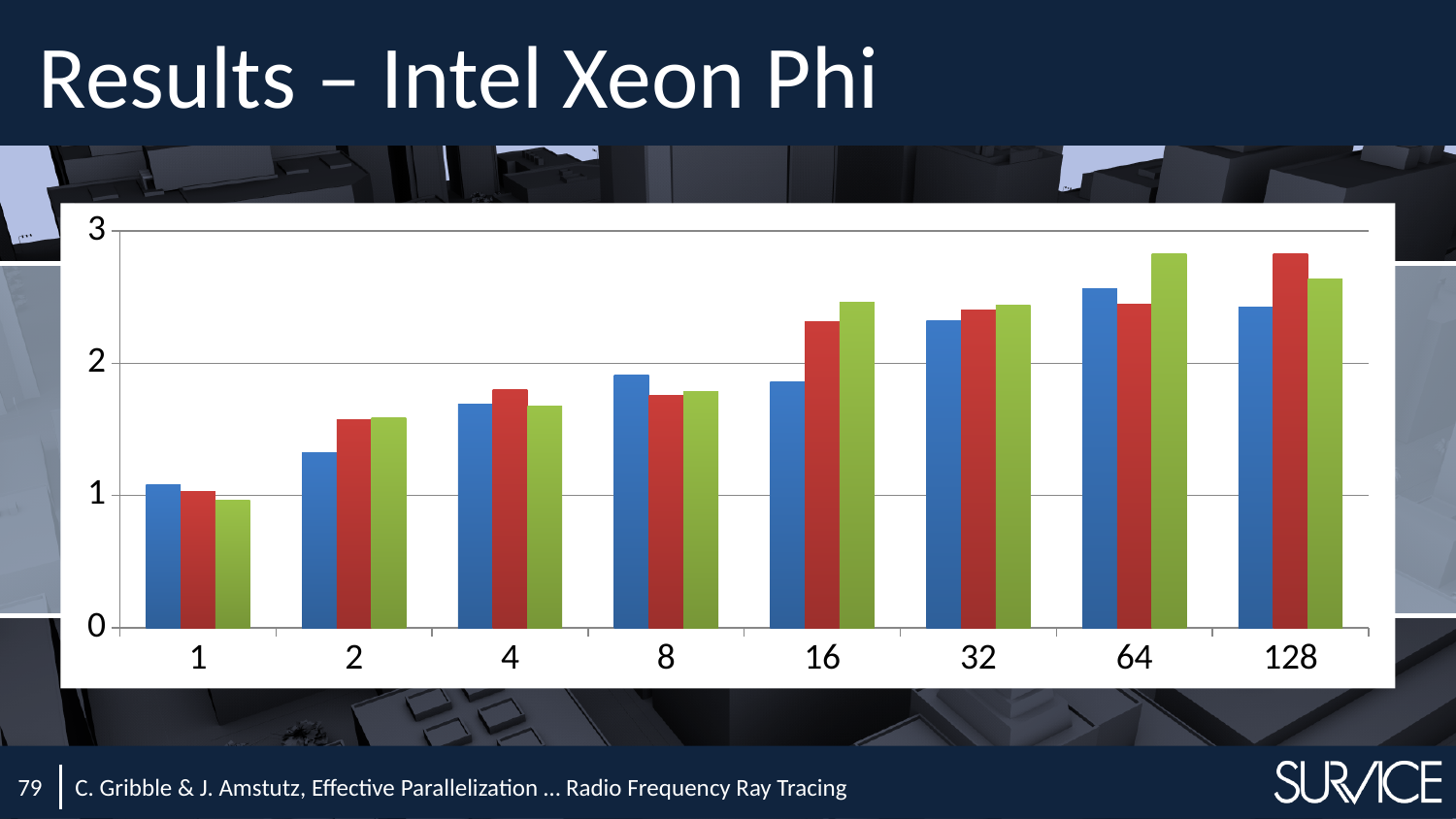
How many bars are plotted for each x-axis category? 3 Is the green bar for category 64 greater or less than 2? greater Is the blue bar for category 2 greater or less than 1? greater For which category is the blue bar the highest? 64 At category 64, which is larger, the green bar or the red bar? green What kind of chart is shown on the slide? bar chart At category 8, which is larger, the blue bar or the red bar? blue What is the label of the first category on the x axis? 1 Is the red bar for category 16 greater or less than 2? greater What is the highest value shown on the y axis? 3 How many categories are shown along the x axis? 8